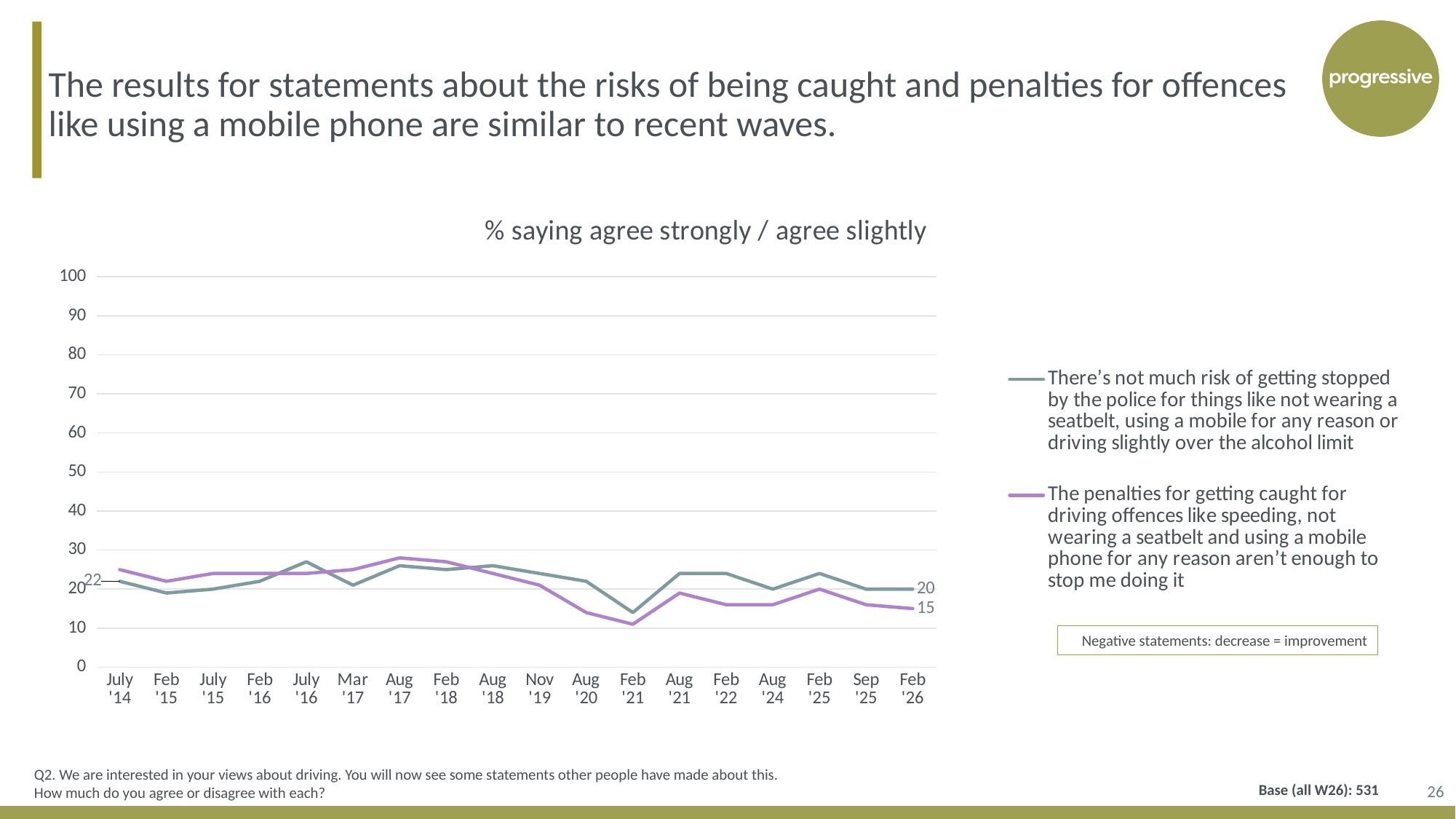
How many time points are shown on the x axis? 18 What type of chart is shown on the slide? line chart What colour is the line for the series 'The penalties for getting caught... aren't enough to stop me doing it'? purple Is the value for Aug '17 for the series 'The penalties for getting caught... aren't enough to stop me doing it' greater or less than 20? greater How many series does the legend list? 2 What is the difference between the two series' values at Feb '26? 5 What is the value for Feb '26 for the series 'There's not much risk of getting stopped by the police...'? 20 What is the value for July '14 for the series 'There's not much risk of getting stopped by the police...'? 22 What is the title of the chart? % saying agree strongly / agree slightly At Feb '26, which series has the higher value: 'There's not much risk of getting stopped by the police...' or 'The penalties for getting caught... aren't enough to stop me doing it'? There's not much risk of getting stopped by the police... What is the value for Feb '26 for the series 'The penalties for getting caught for driving offences... aren't enough to stop me doing it'? 15 Is the value for Feb '21 for the series 'The penalties for getting caught... aren't enough to stop me doing it' greater or less than 20? less